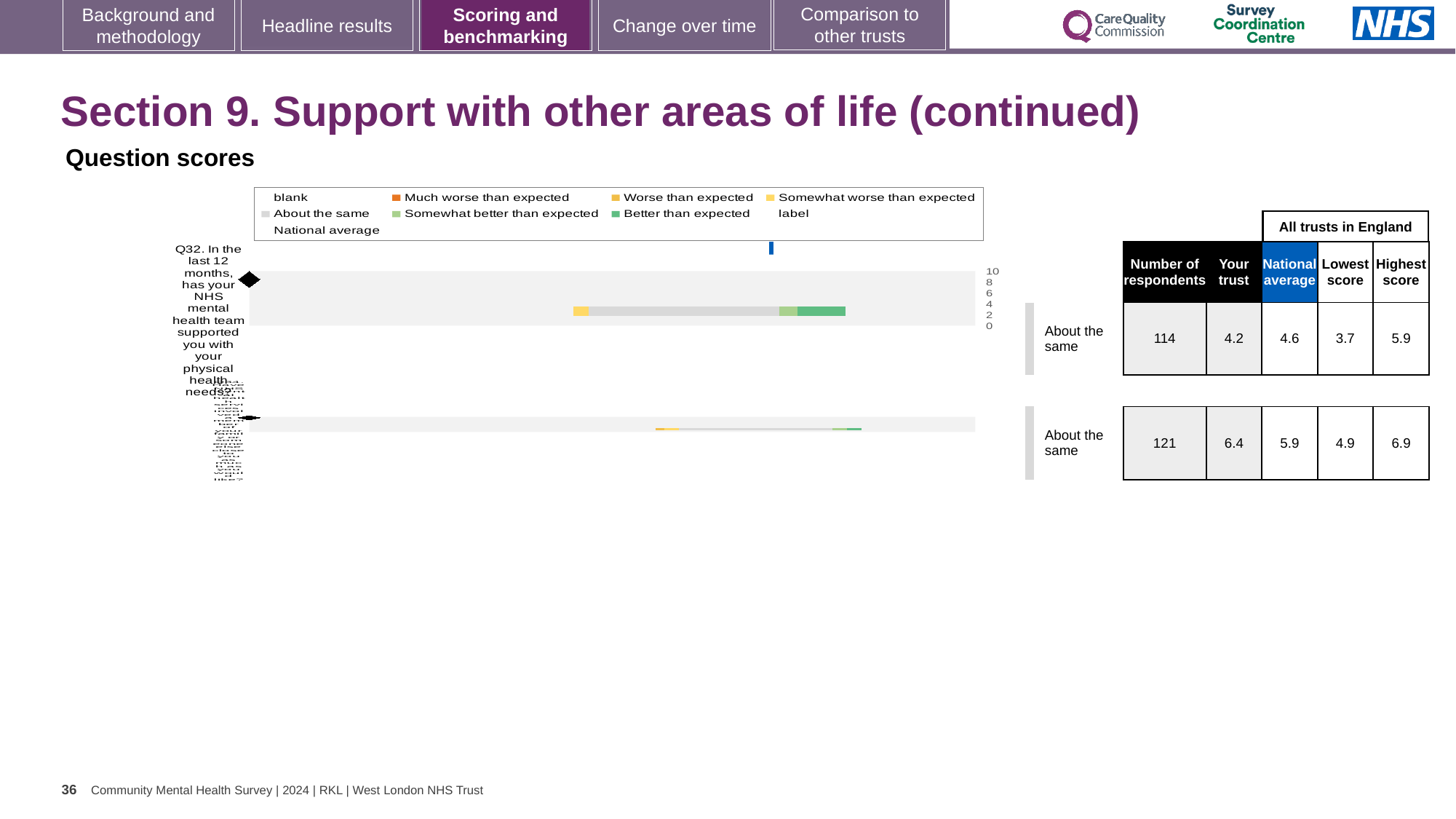
For Q32, which is larger: the trust's score or the national average? National average What is the difference between the national average and the trust's score for Q32? 0.4 What type of chart is used to show the question scores? Bar chart What benchmark category is shown for Q32? About the same How many question rows are plotted in the chart? 2 What is the lowest score among all trusts in England for Q32? 3.7 What is the difference between the highest and lowest scores for Q32 across all trusts in England? 2.2 How many respondents answered Q32? 114 What is the national average score for Q32? 4.6 What is the highest score among all trusts in England for Q32? 5.9 What colour represents 'Much worse than expected' in the legend? Orange What is the 'Your trust' score for Q32 in the table? 4.2